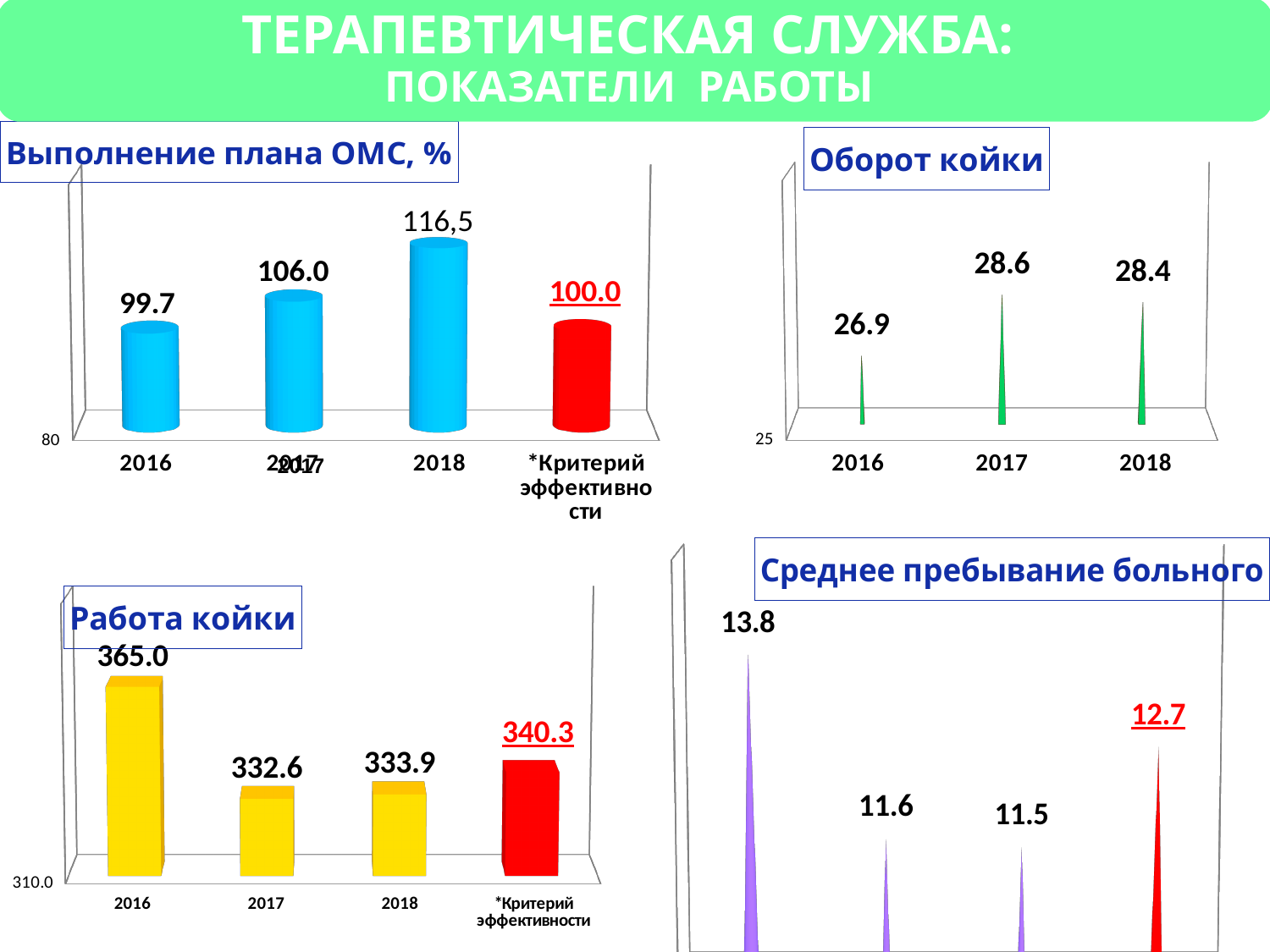
In the chart 'Работа койки', what is the difference between the 2016 value and the 2018 value? 31.1 In the chart 'Выполнение плана ОМС, %', what is the value for 2018? 116,5 In the chart 'Выполнение плана ОМС, %', what is the difference between the 2017 value and the 2016 value? 6.3 In the chart 'Среднее пребывание больного', what is the highest value shown? 13.8 In the chart 'Работа койки', what is the value for 2017? 332.6 In the chart 'Оборот койки', what is the value for 2016? 26.9 In the chart 'Выполнение плана ОМС, %', what is the value for 'Критерий эффективности'? 100.0 In the chart 'Оборот койки', how many years are shown on the x axis? 3 In the chart 'Оборот койки', which year has the highest value? 2017 In the chart 'Среднее пребывание больного', what value is labelled on the red spike? 12.7 In the chart 'Работа койки', which is larger, the value for 2016 or the value for 'Критерий эффективности'? 2016 In the chart 'Выполнение плана ОМС, %', which year has the lowest value? 2016